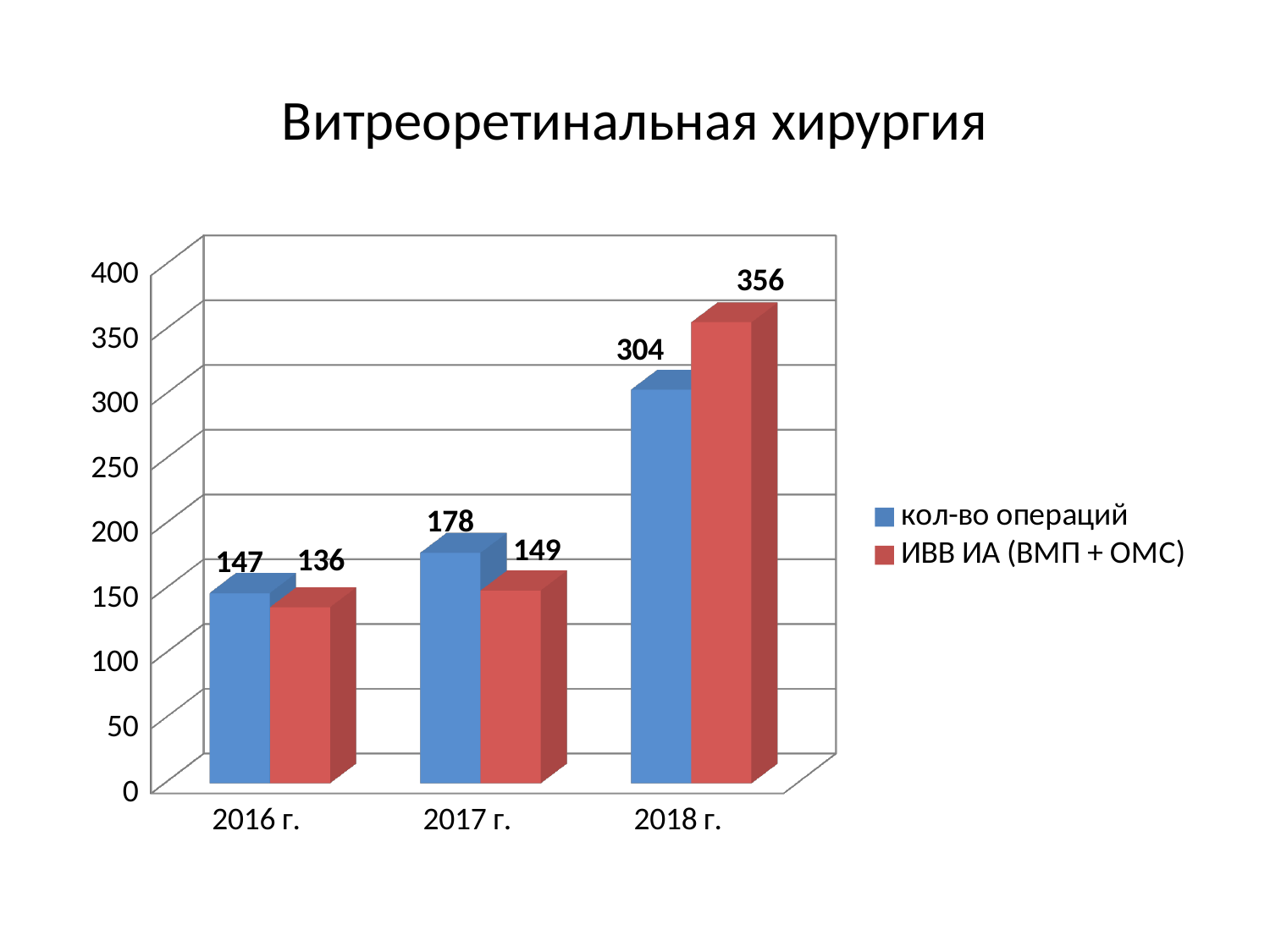
Which is larger in 2017 г.: "кол-во операций" or "ИВВ ИА (ВМП + ОМС)"? кол-во операций How many years are shown on the x axis? 3 In which year is "ИВВ ИА (ВМП + ОМС)" lowest? 2016 г. What kind of chart is shown on the slide? bar chart What is the title of the chart? Витреоретинальная хирургия How many series does the legend list? 2 What is the value of "ИВВ ИА (ВМП + ОМС)" for 2017 г.? 149 Does "кол-во операций" rise or fall from 2016 г. to 2018 г.? rise What is the value of "ИВВ ИА (ВМП + ОМС)" for 2018 г.? 356 In which year is "кол-во операций" highest? 2018 г. What is the difference between "ИВВ ИА (ВМП + ОМС)" and "кол-во операций" in 2018 г.? 52 What is the value of "кол-во операций" for 2016 г.? 147